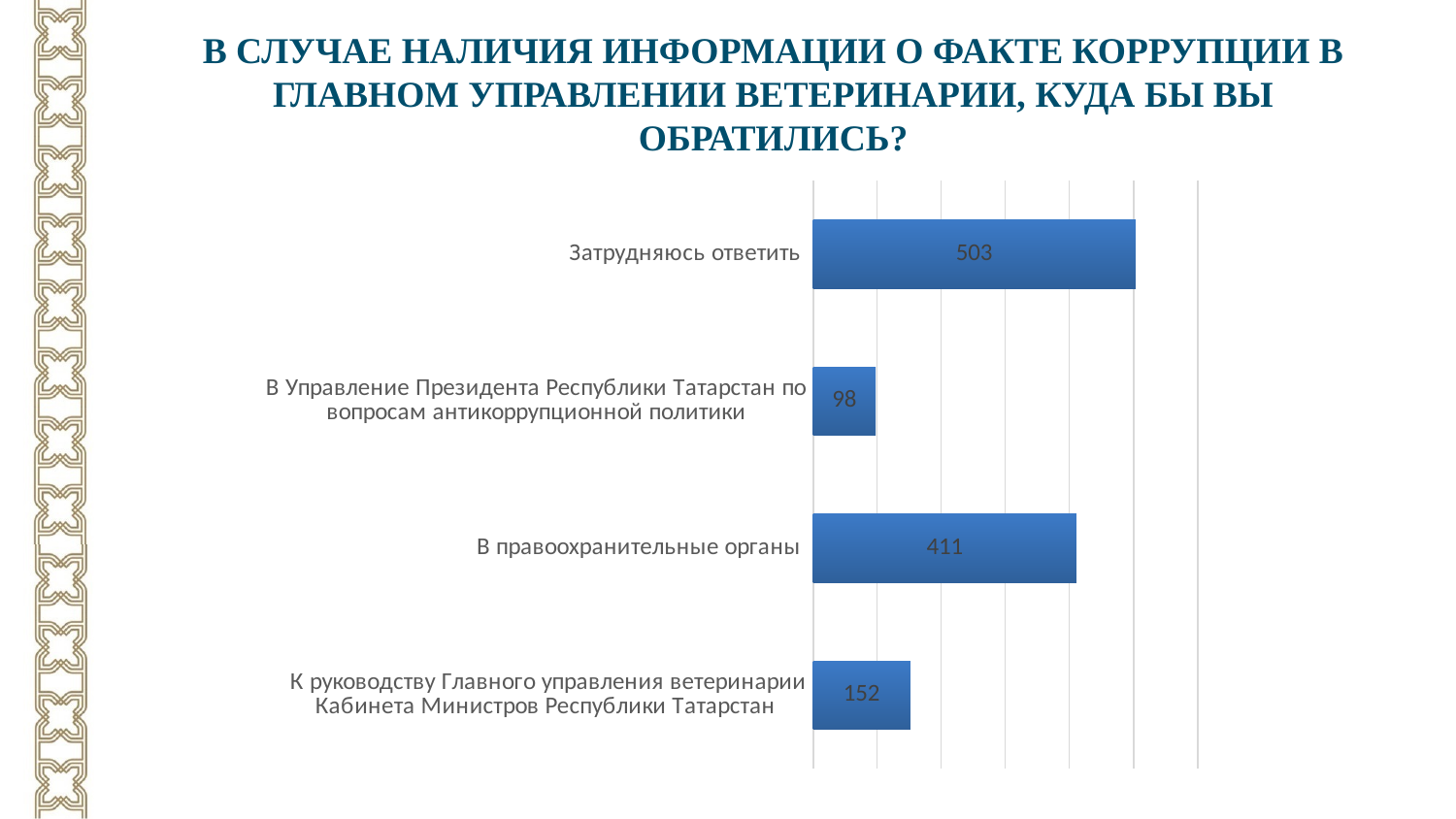
What is the value for "В Управление Президента Республики Татарстан по вопросам антикоррупционной политики"? 98 What is the value for "В правоохранительные органы"? 411 How many categories are shown in the chart? 4 Which category has the highest value? Затрудняюсь ответить What type of chart is shown on the slide? Bar chart Which category has the lowest value? В Управление Президента Республики Татарстан по вопросам антикоррупционной политики What is the title of the slide? В СЛУЧАЕ НАЛИЧИЯ ИНФОРМАЦИИ О ФАКТЕ КОРРУПЦИИ В ГЛАВНОМ УПРАВЛЕНИИ ВЕТЕРИНАРИИ, КУДА БЫ ВЫ ОБРАТИЛИСЬ? What is the difference between the values for "К руководству Главного управления ветеринарии Кабинета Министров Республики Татарстан" and "В Управление Президента Республики Татарстан по вопросам антикоррупционной политики"? 54 Which is larger: the value for "В правоохранительные органы" or the value for "К руководству Главного управления ветеринарии Кабинета Министров Республики Татарстан"? В правоохранительные органы What is the value for "К руководству Главного управления ветеринарии Кабинета Министров Республики Татарстан"? 152 What is the difference between the values for "Затрудняюсь ответить" and "В правоохранительные органы"? 92 What is the value for "Затрудняюсь ответить"? 503